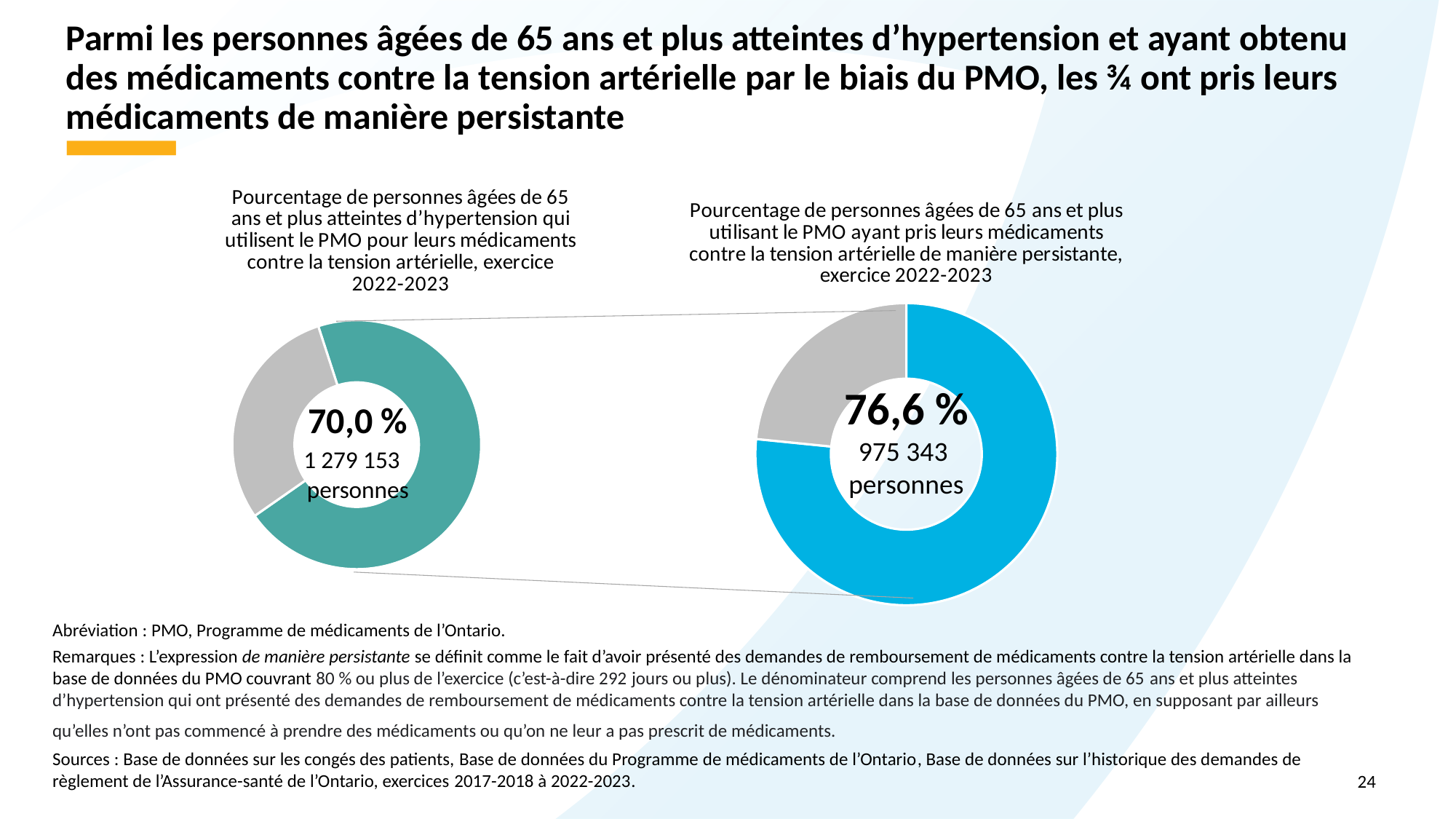
What percentage is shown in the centre of the right donut chart (percentage of people aged 65 and over using the PMO who took their blood pressure medication persistently, 2022-2023)? 76,6 % What kind of chart is used on this slide to show the two percentages? Donut (pie) chart What colour is the main (highlighted) segment of the right donut chart? Blue Is the value shown in the right donut chart greater or less than 75 %? greater What is the difference in percentage points between the right chart's value (76,6 %) and the left chart's value (70,0 %)? 6,6 points In the left donut chart, what share of the ring is taken by the grey (remaining) segment? 30,0 % Which chart shows the larger percentage, the left one (use of the PMO) or the right one (persistent medication use)? The right one (76,6 %) How many people does the right donut chart say took their blood pressure medication persistently? 975 343 personnes What percentage is shown in the centre of the left donut chart (percentage of people aged 65 and over with hypertension who use the PMO for blood pressure medication, 2022-2023)? 70,0 % How many people does the left donut chart say use the PMO for their blood pressure medication? 1 279 153 personnes What colour is the main (highlighted) segment of the left donut chart? Teal/green How many donut charts are shown on the slide? 2